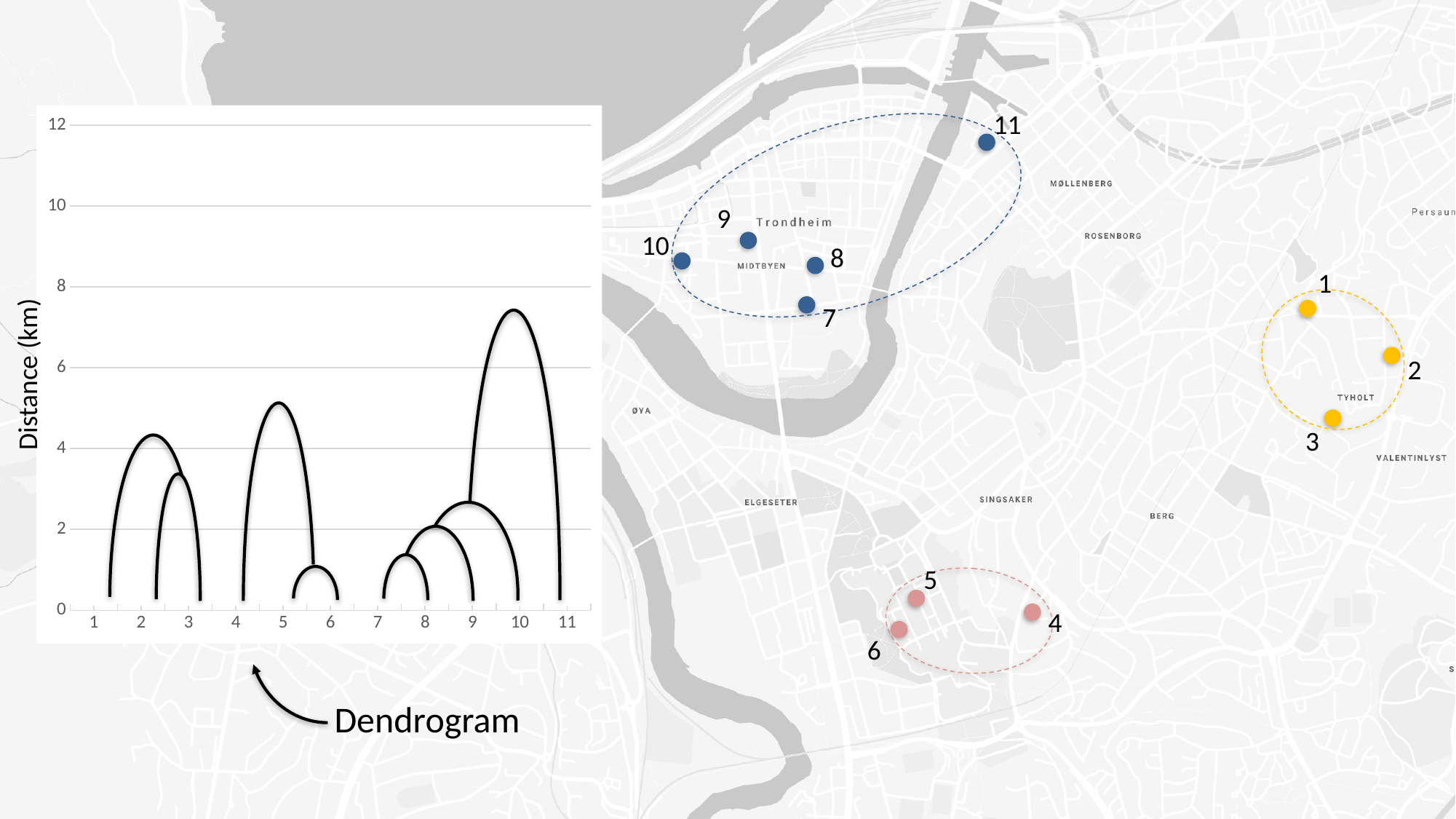
Is the distance at which items 5 and 6 are joined greater or less than 2? less Which is joined at a greater distance: items 1 and 2, or items 4 and 5? 4 and 5 Which is joined at a greater distance: items 2 and 3, or items 8 and 9? 2 and 3 What is the label of the y axis of the dendrogram? Distance (km) What is the highest tick value shown on the y axis of the dendrogram? 12 Is the distance at which items 4 and 5 are joined greater or less than 6? less Is the distance at which items 1 and 2 are joined greater or less than 4? greater What kind of chart is shown on the left of the slide? Dendrogram How many items are labelled along the x axis of the dendrogram? 11